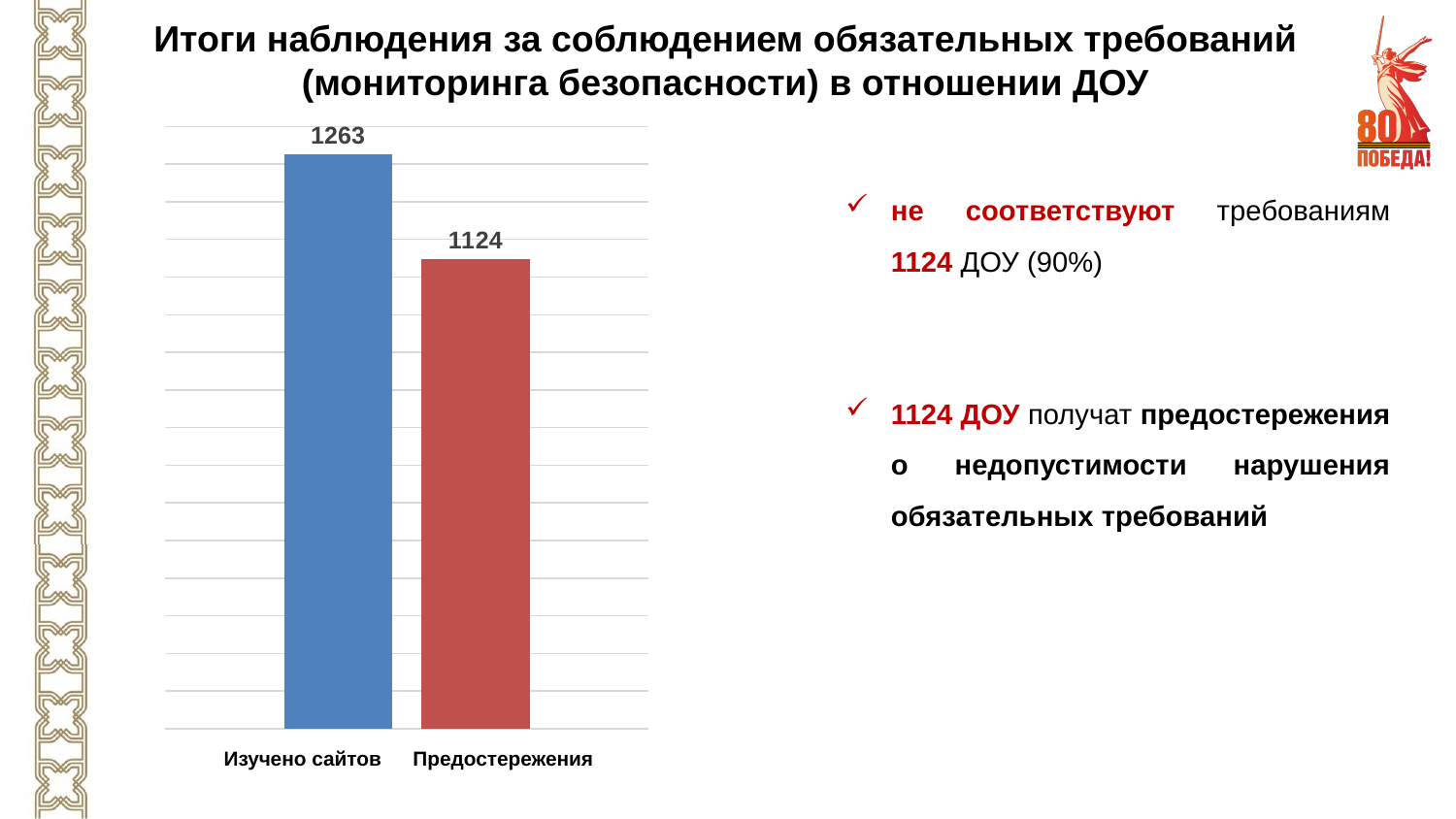
Which category has the highest value? Изучено сайтов What is the difference between the values for Изучено сайтов and Предостережения? 139 Which category has the lowest value? Предостережения Do the values rise or fall from left to right across the categories? fall How many categories are shown in the chart? 2 What colour is the bar for Предостережения? red What kind of chart is shown on the slide? bar chart What is the value for Изучено сайтов? 1263 What colour is the bar for Изучено сайтов? blue Which is larger, the value for Изучено сайтов or the value for Предостережения? Изучено сайтов What is the value for Предостережения? 1124